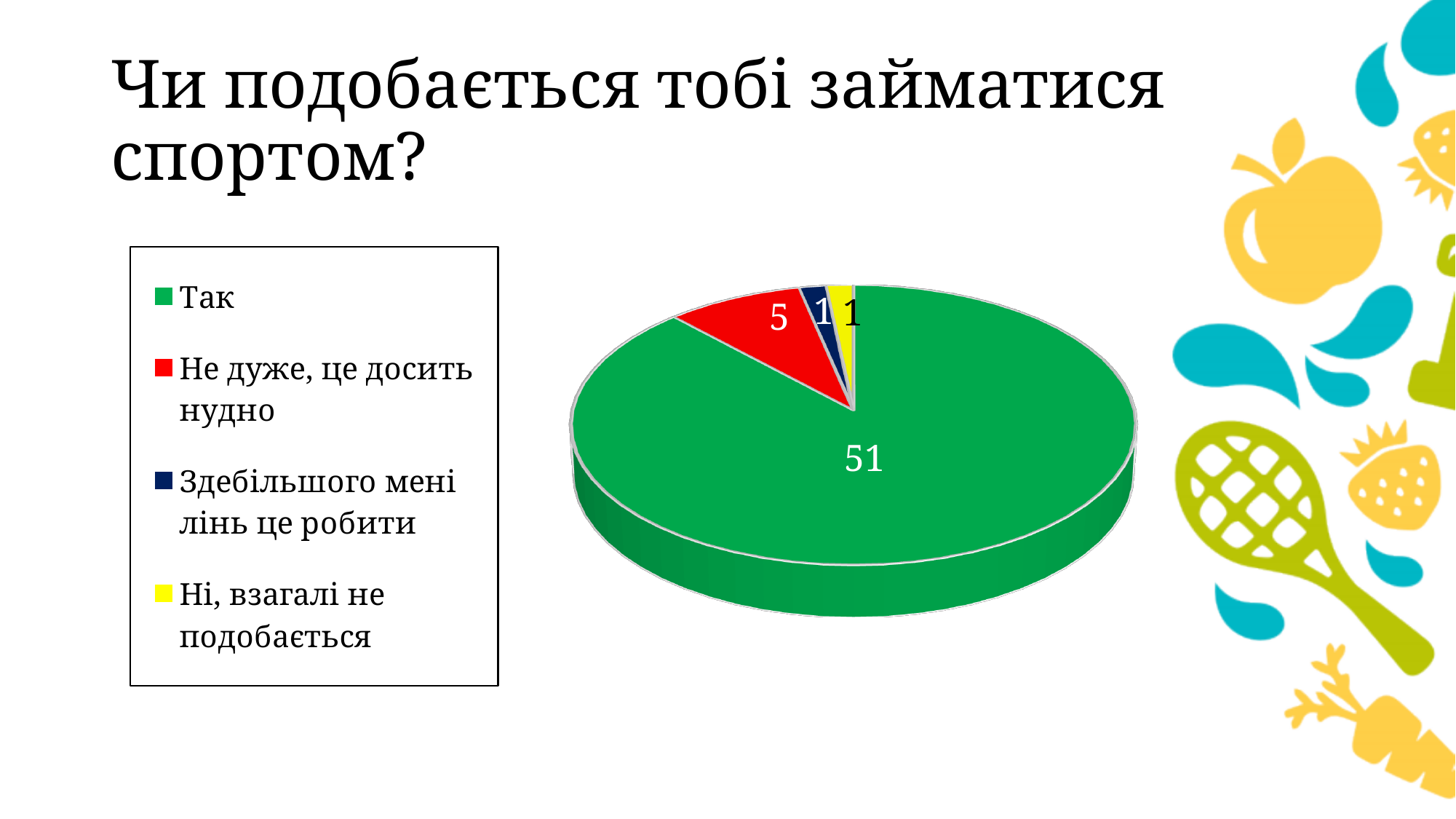
What is the value for "Ні, взагалі не подобається"? 1 What is the value for "Не дуже, це досить нудно"? 5 Which is larger: the value for "Не дуже, це досить нудно" or the value for "Ні, взагалі не подобається"? Не дуже, це досить нудно What is the difference between the values for "Так" and "Не дуже, це досить нудно"? 46 What colour is the slice for "Так"? green What is the total of all the values shown on the pie chart? 58 What kind of chart is shown on the slide? pie chart How many respondents answered "Так"? 51 What is the title of the slide containing the pie chart? Чи подобається тобі займатися спортом? How many categories does the pie chart have? 4 What is the value for "Здебільшого мені лінь це робити"? 1 Which answer option has the largest slice of the pie? Так